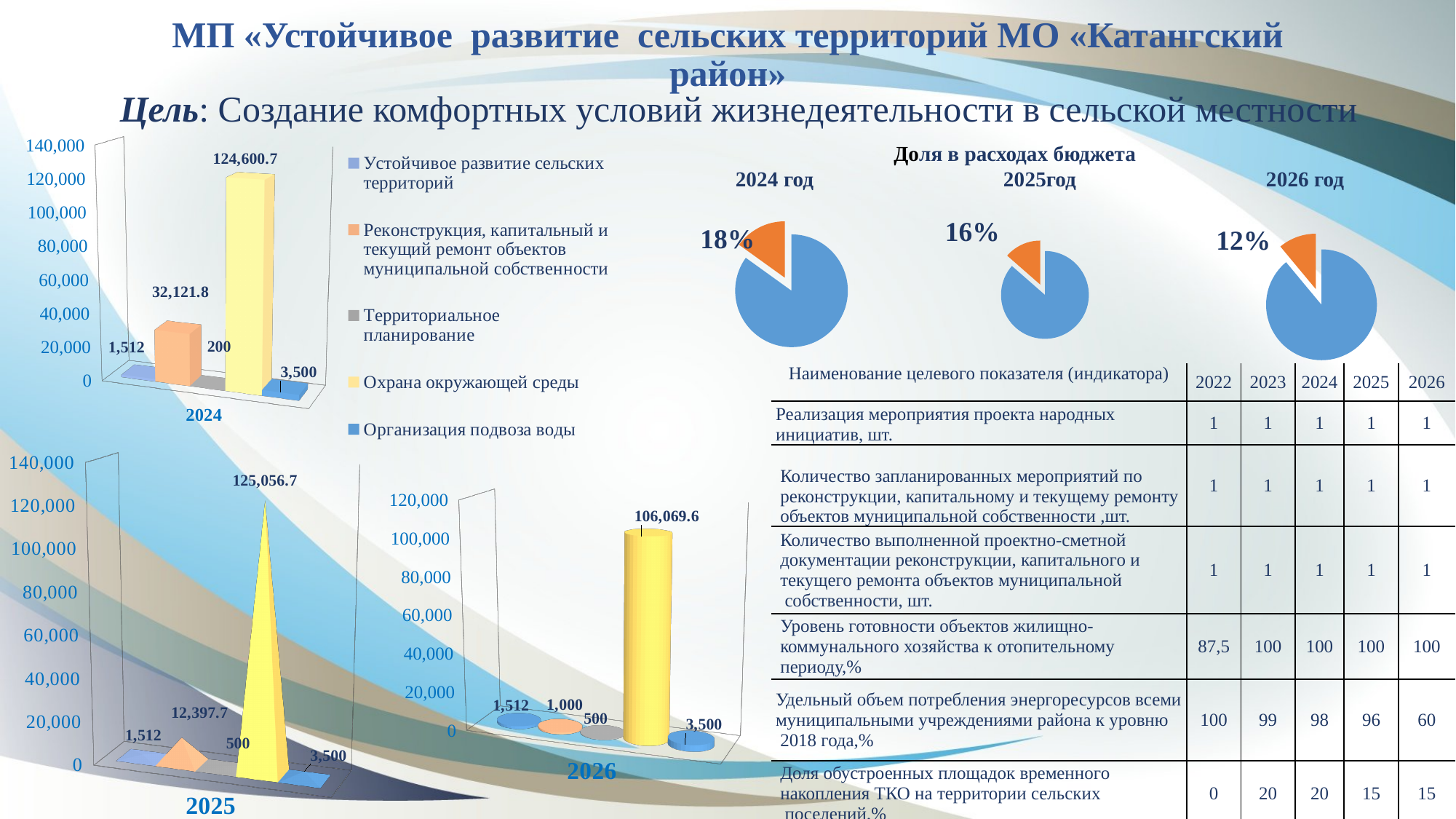
In the 2024 год pie chart under Доля в расходах бюджета, what share does the orange slice represent? 18% In the 2024 bar chart, which series has the highest value? Охрана окружающей среды Across the three pie charts under Доля в расходах бюджета, does the labelled share rise or fall from 2024 to 2026? Fall In the 2026 bar chart, which is larger: the value for Реконструкция, капитальный и текущий ремонт объектов муниципальной собственности or the value for Организация подвоза воды? Организация подвоза воды In the 2026 bar chart, what is the value for Охрана окружающей среды? 106,069.6 In the 2026 год pie chart under Доля в расходах бюджета, what share is labelled? 12% What kind of chart is the 2025 chart on the left of the slide? Bar chart How many series does the legend of the bar charts list? 5 In the 2024 bar chart, what is the value for Охрана окружающей среды? 124,600.7 In the 2024 bar chart, what is the difference between the value for Реконструкция, капитальный и текущий ремонт объектов муниципальной собственности and the value for Организация подвоза воды? 28,621.8 In the 2025 bar chart, what is the value for Реконструкция, капитальный и текущий ремонт объектов муниципальной собственности? 12,397.7 In the 2024 bar chart, which series has the lowest value? Территориальное планирование